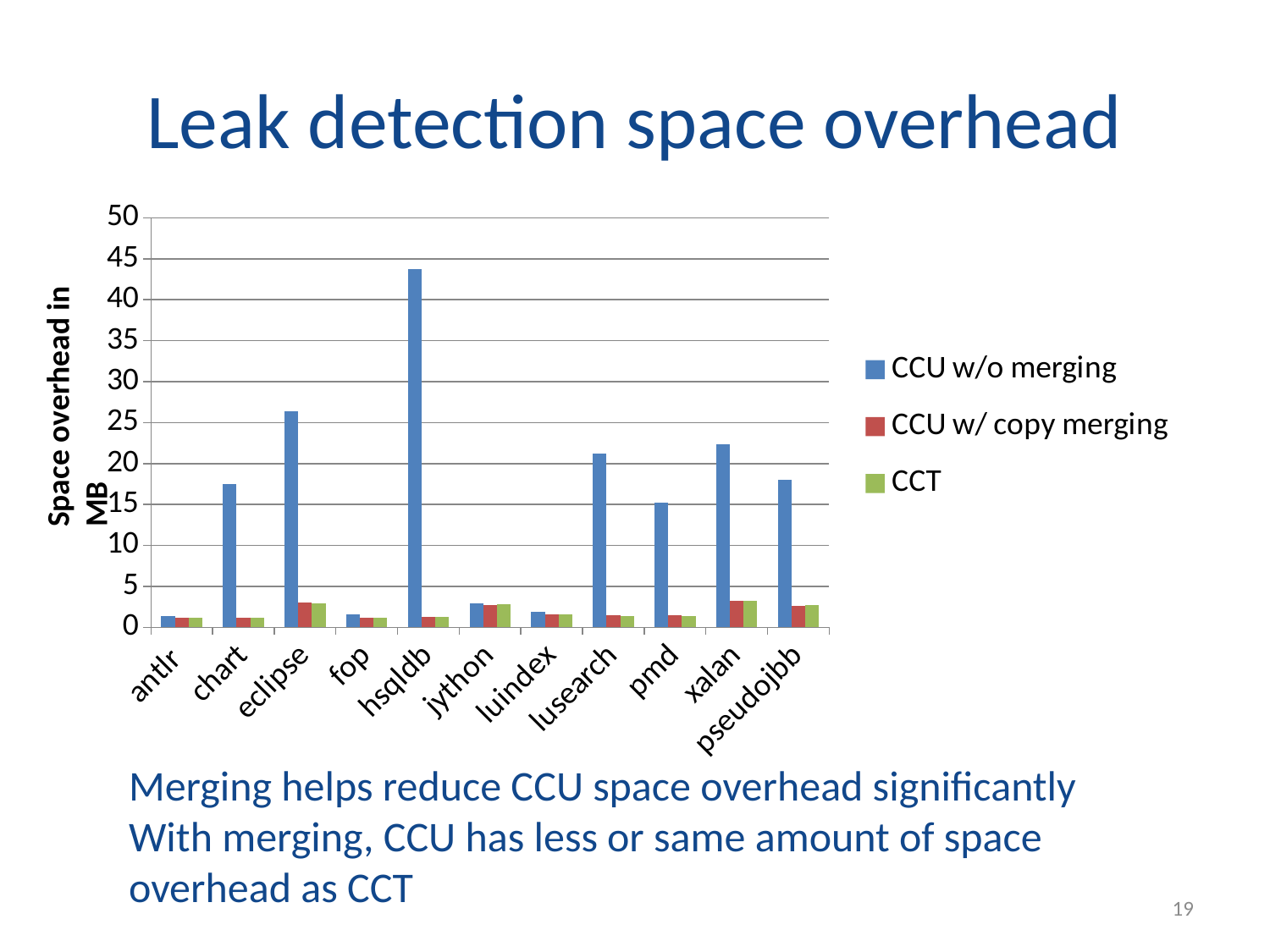
Which series is shown in green in the legend? CCT Which benchmark has the highest CCU w/o merging space overhead? hsqldb How many benchmark categories are shown on the x axis? 11 Is the CCU w/o merging value for hsqldb greater or less than 40? greater Is the CCU w/o merging value for eclipse greater or less than 25? greater Is the CCU w/o merging value for pmd greater or less than 20? less Which is larger for CCU w/o merging: lusearch or pmd? lusearch What is the title of the chart's vertical axis? Space overhead in MB What kind of chart is shown on the slide? bar chart Which is larger for CCU w/o merging: eclipse or chart? eclipse How many series does the legend list? 3